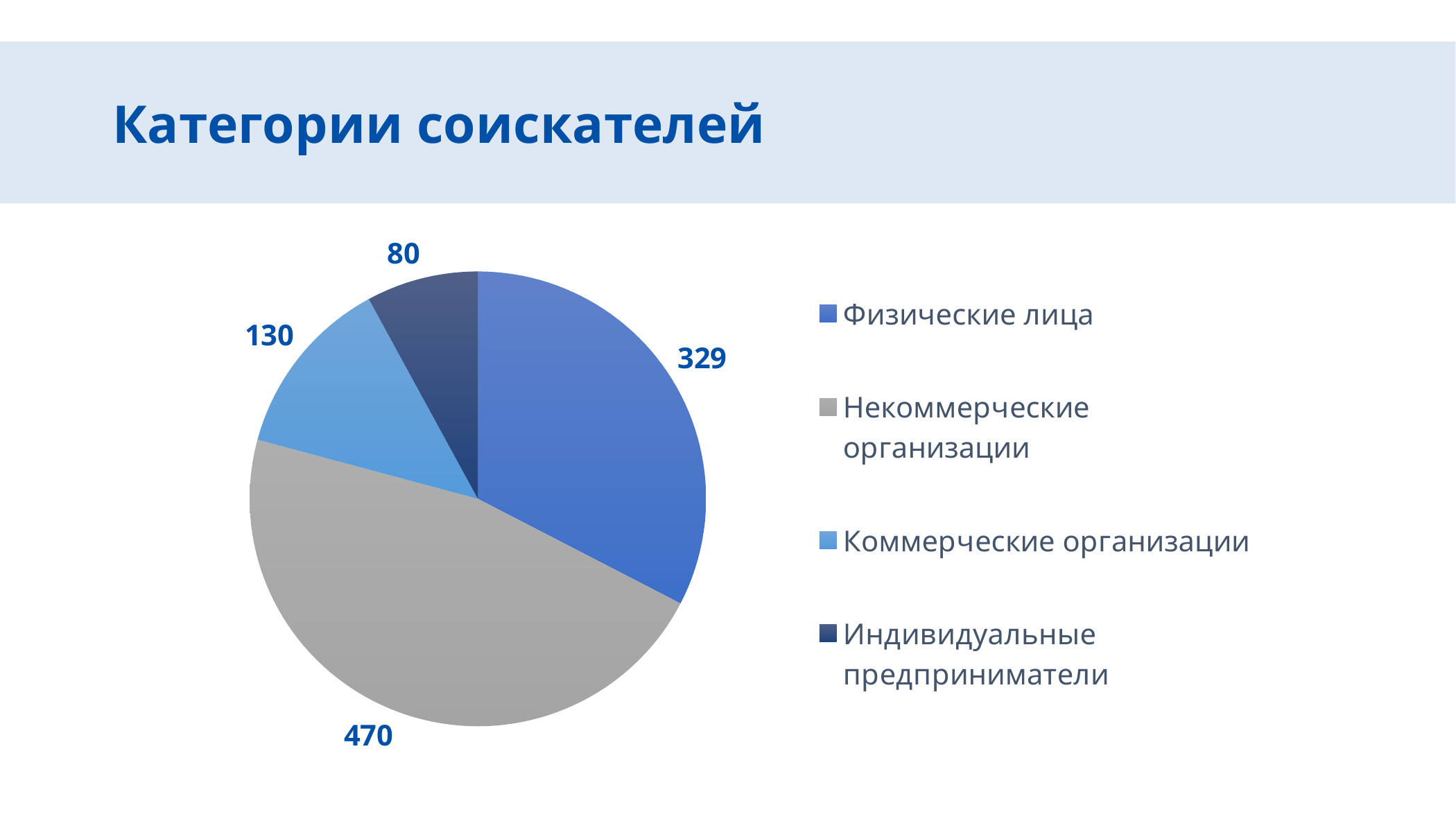
Which category has the largest slice of the pie? Некоммерческие организации What is the title of the slide containing the chart? Категории соискателей What is the difference between the values for Некоммерческие организации and Физические лица? 141 What kind of chart is shown on the slide? Pie chart What is the value for Коммерческие организации? 130 What is the value for Физические лица? 329 How many categories does the pie chart show? 4 What is the value for Некоммерческие организации? 470 Which category has the smallest slice of the pie? Индивидуальные предприниматели What is the value for Индивидуальные предприниматели? 80 Which is larger, the value for Физические лица or the value for Коммерческие организации? Физические лица What is the difference between the values for Коммерческие организации and Индивидуальные предприниматели? 50